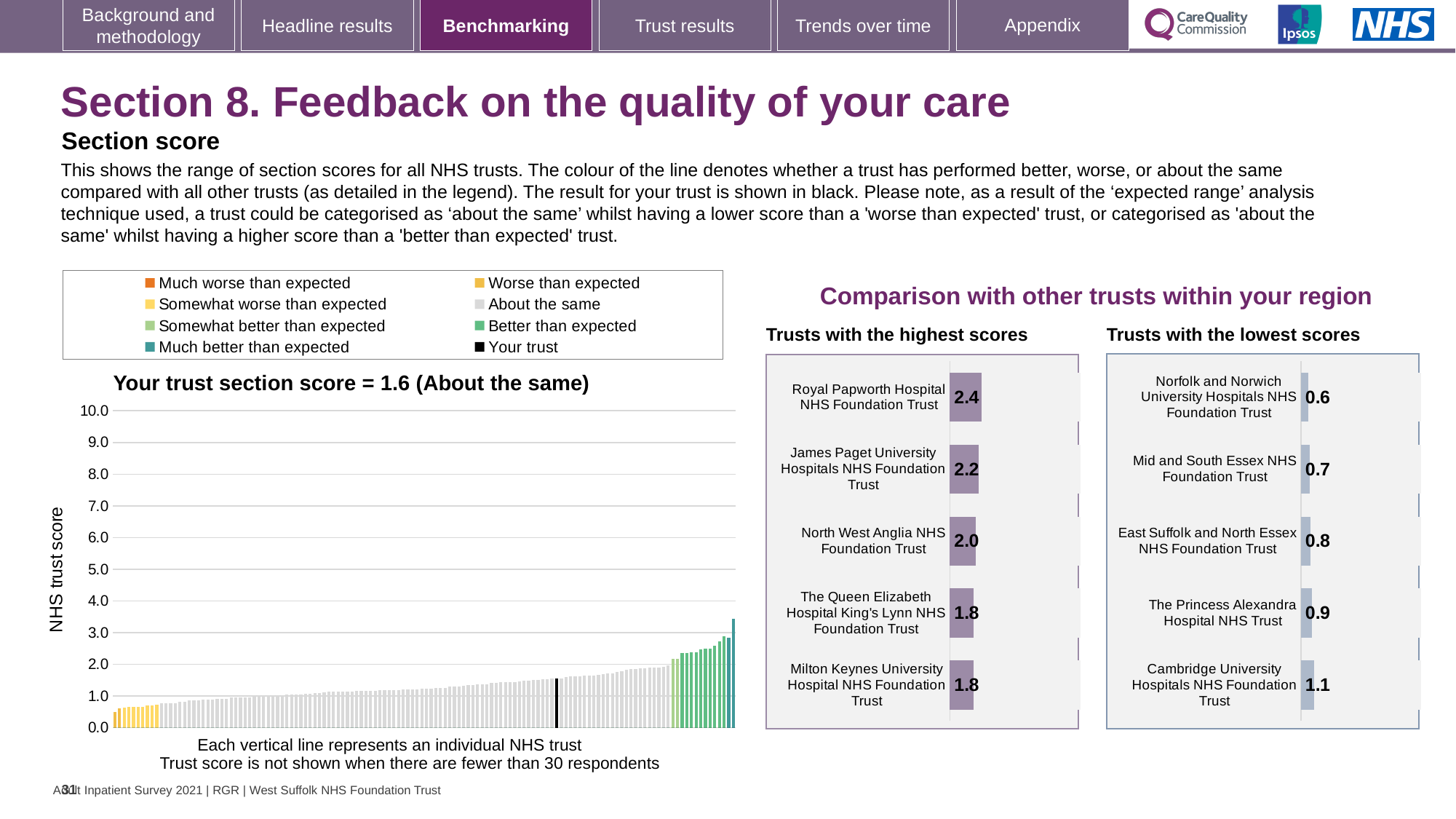
In the 'Trusts with the highest scores' chart, what is the difference between the scores of Royal Papworth Hospital NHS Foundation Trust and James Paget University Hospitals NHS Foundation Trust? 0.2 In the 'Your trust section score' chart, is the value of the tallest bar greater or less than 3.0? greater In the 'Trusts with the highest scores' chart, which trust has the highest score? Royal Papworth Hospital NHS Foundation Trust In the 'Your trust section score' chart, do the values rise or fall from left to right along the x axis? rise In the 'Trusts with the lowest scores' chart, how many trusts are shown? 5 In the 'Your trust section score' chart, what is the section score for your trust? 1.6 In the 'Trusts with the lowest scores' chart, which trust has the lowest score? Norfolk and Norwich University Hospitals NHS Foundation Trust In the 'Trusts with the highest scores' chart, which has the larger score: North West Anglia NHS Foundation Trust or Milton Keynes University Hospital NHS Foundation Trust? North West Anglia NHS Foundation Trust In the 'Trusts with the highest scores' chart, what is the score for Royal Papworth Hospital NHS Foundation Trust? 2.4 In the 'Trusts with the lowest scores' chart, what is the score for Mid and South Essex NHS Foundation Trust? 0.7 How many entries does the legend above the 'Your trust section score' chart list? 8 In the 'Trusts with the lowest scores' chart, what is the difference between the scores of Cambridge University Hospitals NHS Foundation Trust and Norfolk and Norwich University Hospitals NHS Foundation Trust? 0.5